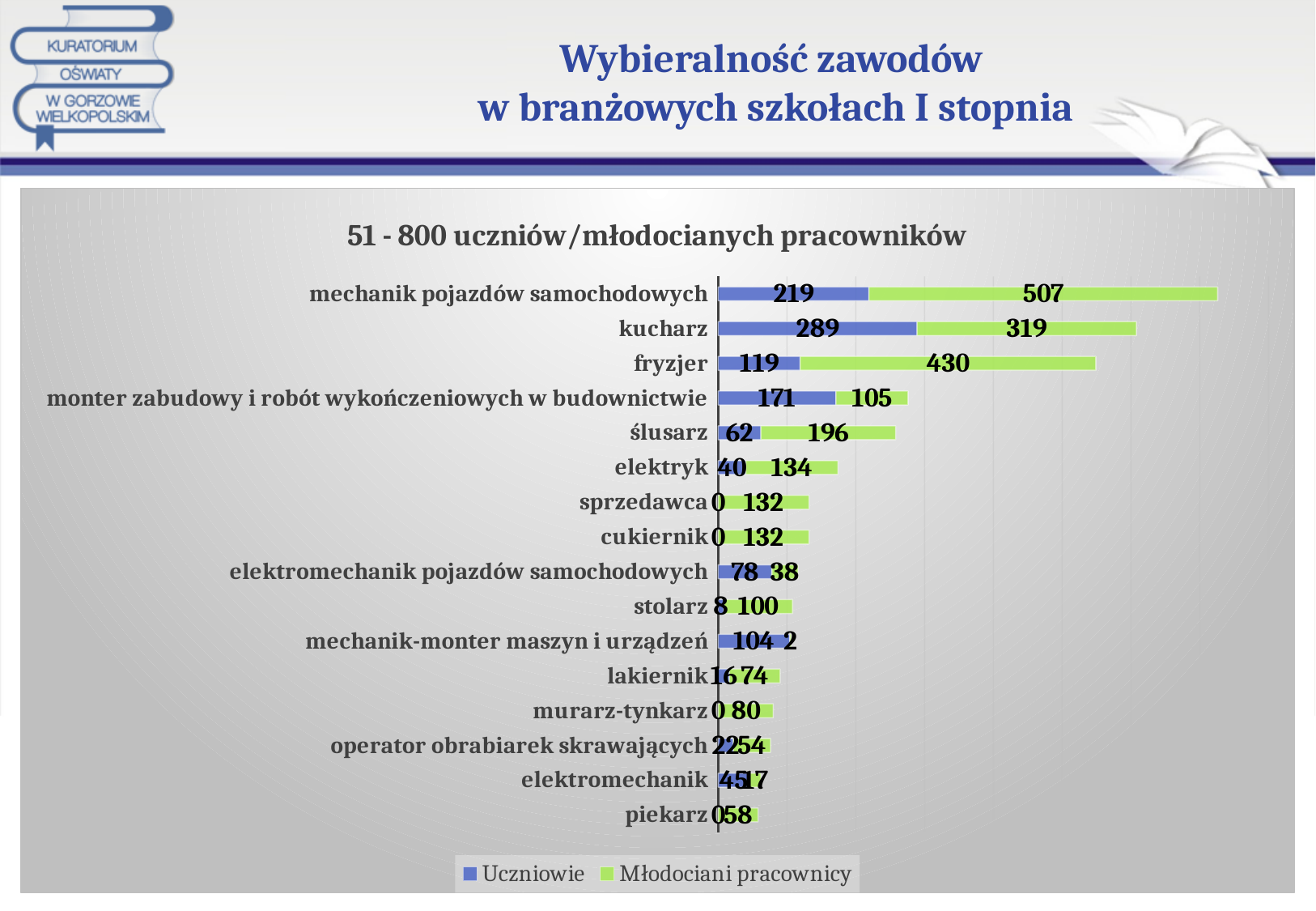
Which occupation has the highest Młodociani pracownicy value? mechanik pojazdów samochodowych What is the difference between the Młodociani pracownicy and Uczniowie values for ślusarz? 134 What is the Młodociani pracownicy value for fryzjer? 430 What is the Uczniowie value for kucharz? 289 What is the total of the stacked bar for mechanik pojazdów samochodowych? 726 What is the Uczniowie value for monter zabudowy i robót wykończeniowych w budownictwie? 171 Which occupation has the highest Uczniowie value? kucharz What is the title of the chart? 51 - 800 uczniów/młodocianych pracowników Which is larger for elektromechanik pojazdów samochodowych: the Uczniowie value or the Młodociani pracownicy value? Uczniowie What kind of chart is shown on the slide? Stacked bar chart How many occupations (categories) are shown in the chart? 16 How many series does the legend list? 2